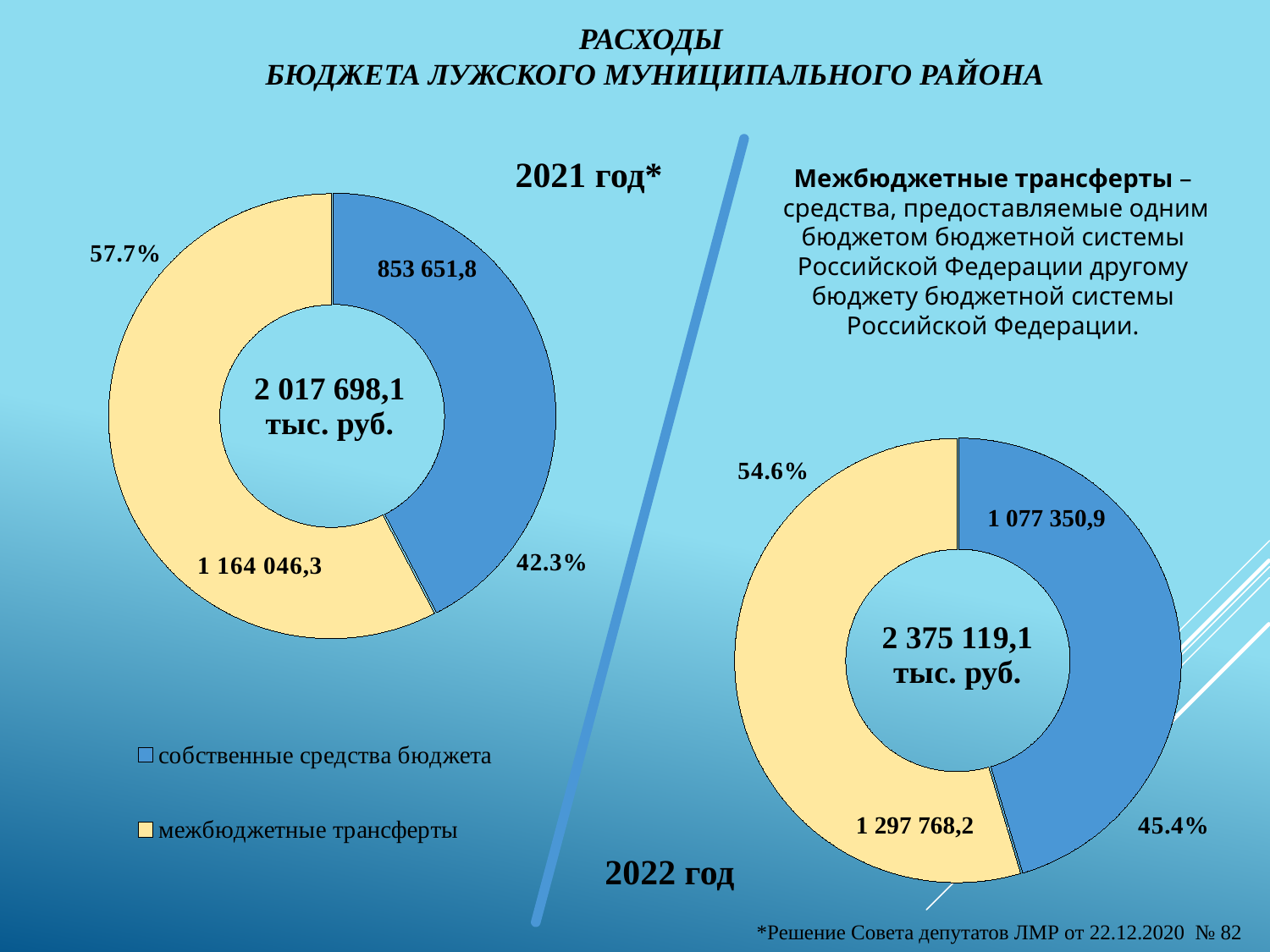
How many categories does the legend list for the charts? 2 In the 2022 год chart, what is the value for межбюджетные трансферты? 1 297 768,2 In the 2021 год chart, which category is the smallest? собственные средства бюджета In the 2022 год chart, which category is the largest? межбюджетные трансферты In the 2021 год chart, what is the value for собственные средства бюджета? 853 651,8 What is the total shown in the centre of the 2022 год chart? 2 375 119,1 тыс. руб. In the 2021 год chart, what is the difference between межбюджетные трансферты and собственные средства бюджета? 310 394,5 In the 2021 год chart, what is the value for межбюджетные трансферты? 1 164 046,3 In the 2022 год chart, what is the value for собственные средства бюджета? 1 077 350,9 What type of chart is used for the 2021 год chart? doughnut chart In the 2021 год chart, what share of the total is межбюджетные трансферты? 57.7% In the 2022 год chart, what share of the total is собственные средства бюджета? 45.4%